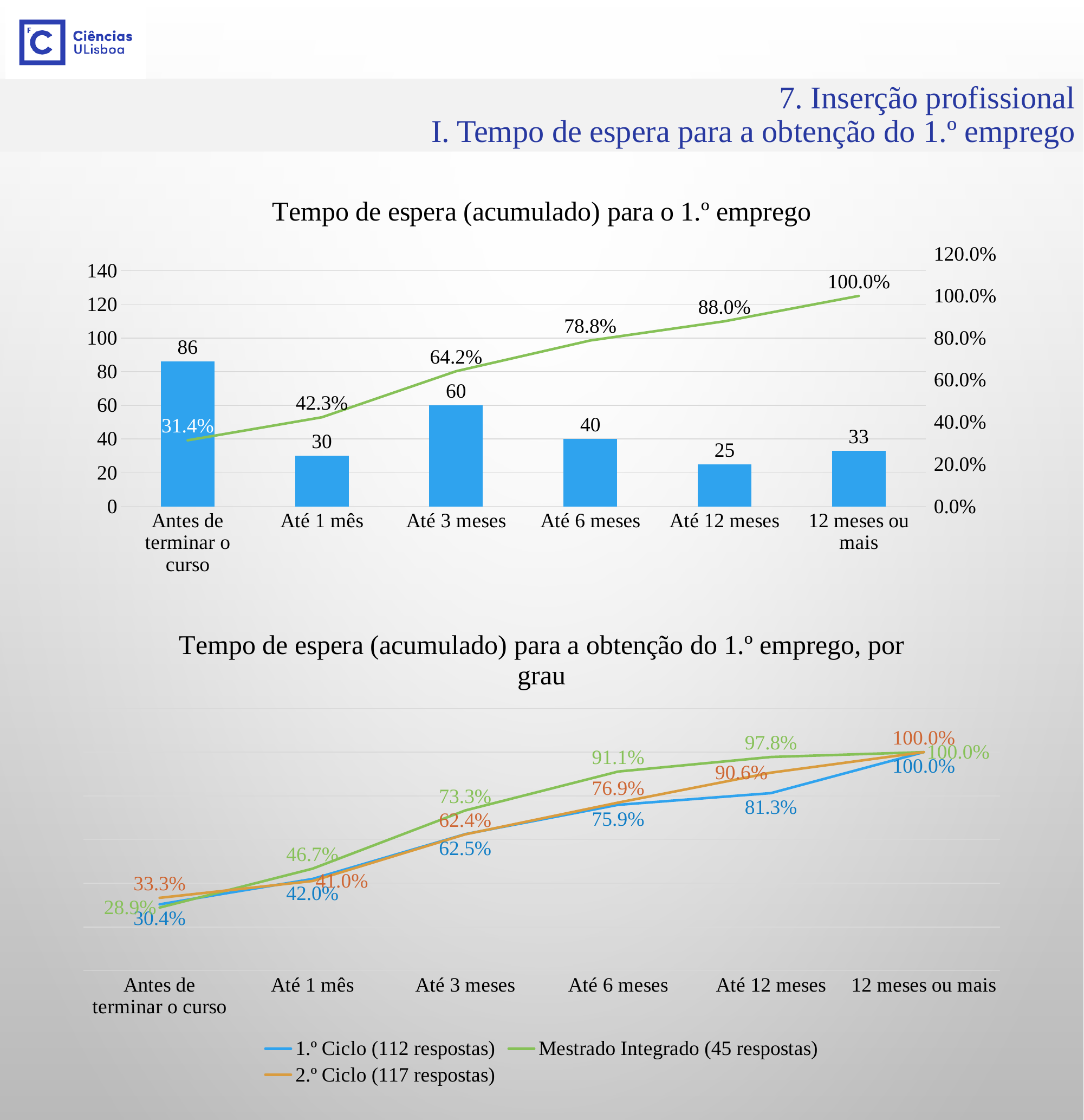
In the chart 'Tempo de espera (acumulado) para a obtenção do 1.º emprego, por grau', which series has the highest value at 'Até 12 meses'? Mestrado Integrado (45 respostas) In the chart 'Tempo de espera (acumulado) para o 1.º emprego', does the cumulative percentage line rise or fall along the x axis? rise In the chart 'Tempo de espera (acumulado) para o 1.º emprego', which category has the lowest bar? Até 12 meses In the chart 'Tempo de espera (acumulado) para a obtenção do 1.º emprego, por grau', what is the value for 'Mestrado Integrado (45 respostas)' at 'Até 6 meses'? 91.1% In the chart 'Tempo de espera (acumulado) para a obtenção do 1.º emprego, por grau', what is the value for '1.º Ciclo (112 respostas)' at 'Até 12 meses'? 81.3% In the chart 'Tempo de espera (acumulado) para a obtenção do 1.º emprego, por grau', how many series does the legend list? 3 In the chart 'Tempo de espera (acumulado) para o 1.º emprego', how many responses are shown for 'Antes de terminar o curso'? 86 What type of chart is 'Tempo de espera (acumulado) para a obtenção do 1.º emprego, por grau'? line chart In the chart 'Tempo de espera (acumulado) para o 1.º emprego', which bar is taller: 'Até 1 mês' or '12 meses ou mais'? 12 meses ou mais In the chart 'Tempo de espera (acumulado) para o 1.º emprego', how many categories are shown on the x axis? 6 In the chart 'Tempo de espera (acumulado) para o 1.º emprego', what cumulative percentage is shown at 'Até 6 meses'? 78.8% In the chart 'Tempo de espera (acumulado) para o 1.º emprego', what is the difference between the bar values for 'Até 3 meses' and 'Até 6 meses'? 20